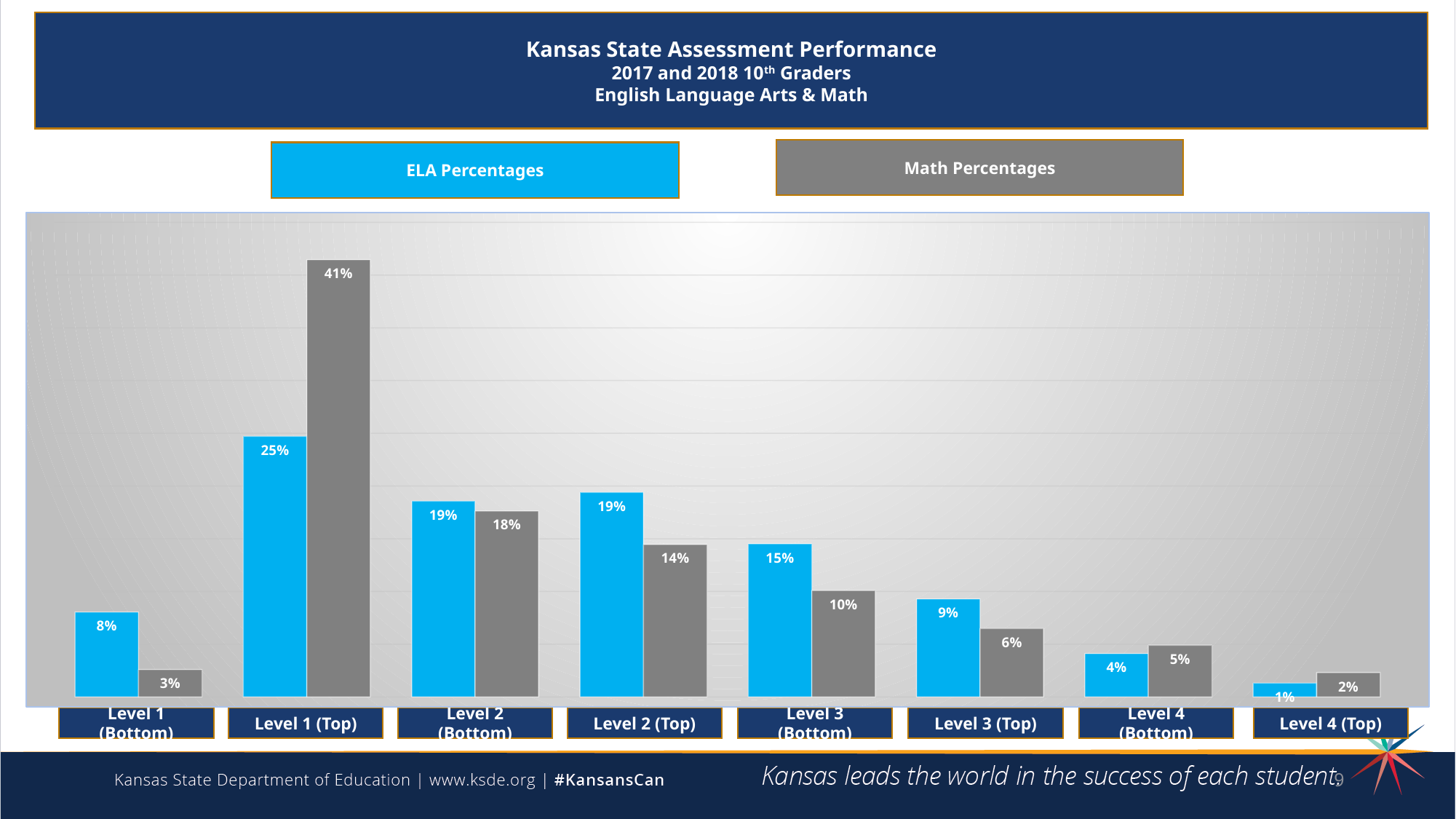
Which is larger for Level 2 (Top), the ELA percentage or the Math percentage? ELA percentage What is the Math percentage for Level 1 (Top)? 41% What is the Math percentage for Level 3 (Bottom)? 10% Which is larger for Level 4 (Bottom), the ELA percentage or the Math percentage? Math percentage Which category has the highest Math percentage? Level 1 (Top) How many series does the chart show? 2 How many categories are shown on the x axis? 8 What is the ELA percentage for Level 1 (Top)? 25% What is the ELA percentage for Level 4 (Top)? 1% Which category has the lowest ELA percentage? Level 4 (Top) What is the difference between the Math and ELA percentages for Level 1 (Top)? 16% What type of chart is shown on the slide? Bar chart